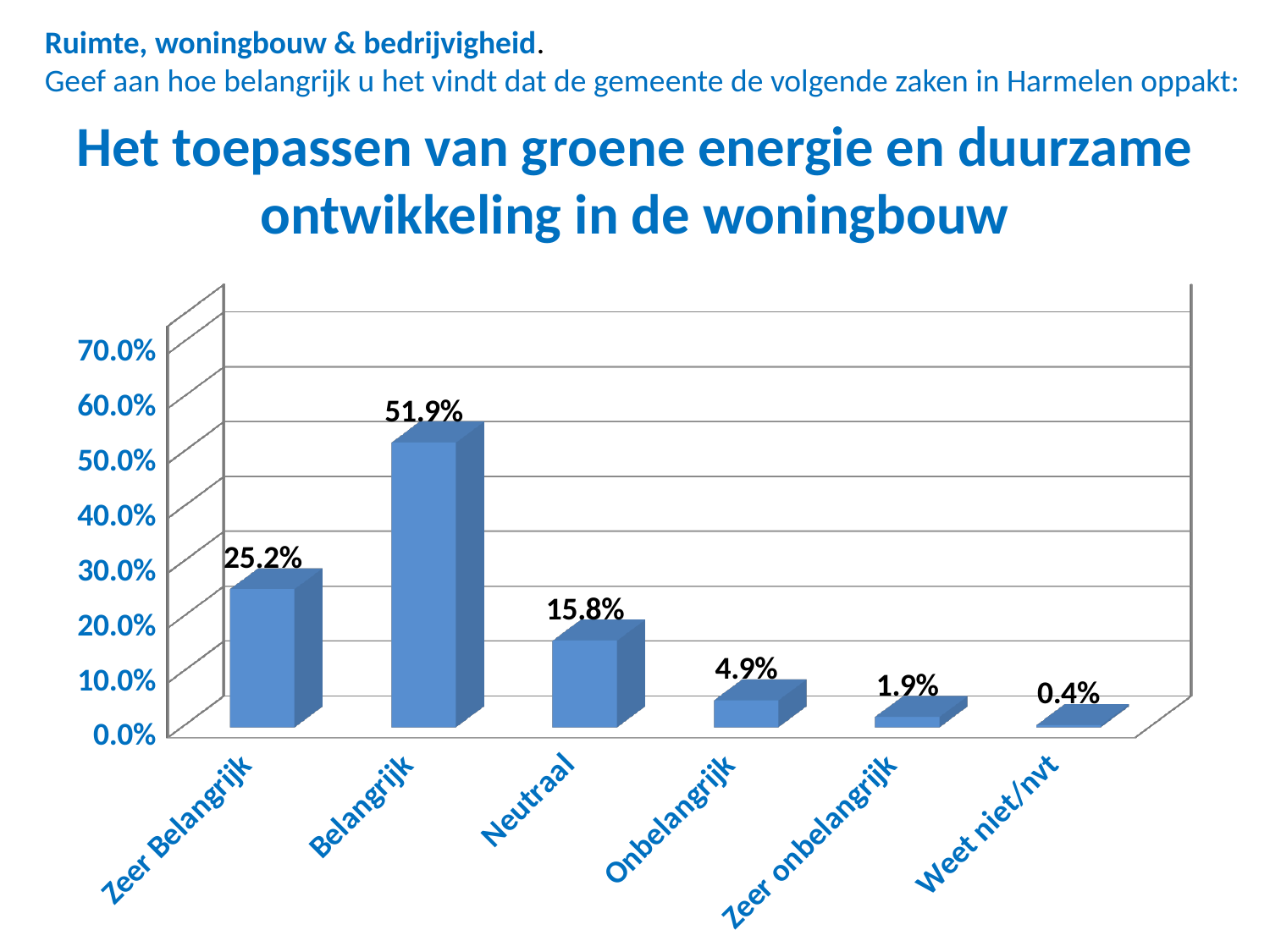
How many categories are shown on the x axis? 6 What is the value for Neutraal? 15.8% Which category has the highest value? Belangrijk Is the value for Neutraal greater or less than 20.0%? less Which is larger, the value for Onbelangrijk or the value for Zeer onbelangrijk? Onbelangrijk What kind of chart is shown on the slide? bar chart What is the value for Zeer Belangrijk? 25.2% What is the value for Belangrijk? 51.9% What is the difference between the values for Belangrijk and Zeer Belangrijk? 26.7% What is the title of the chart? Het toepassen van groene energie en duurzame ontwikkeling in de woningbouw Which category has the lowest value? Weet niet/nvt What is the value for Weet niet/nvt? 0.4%